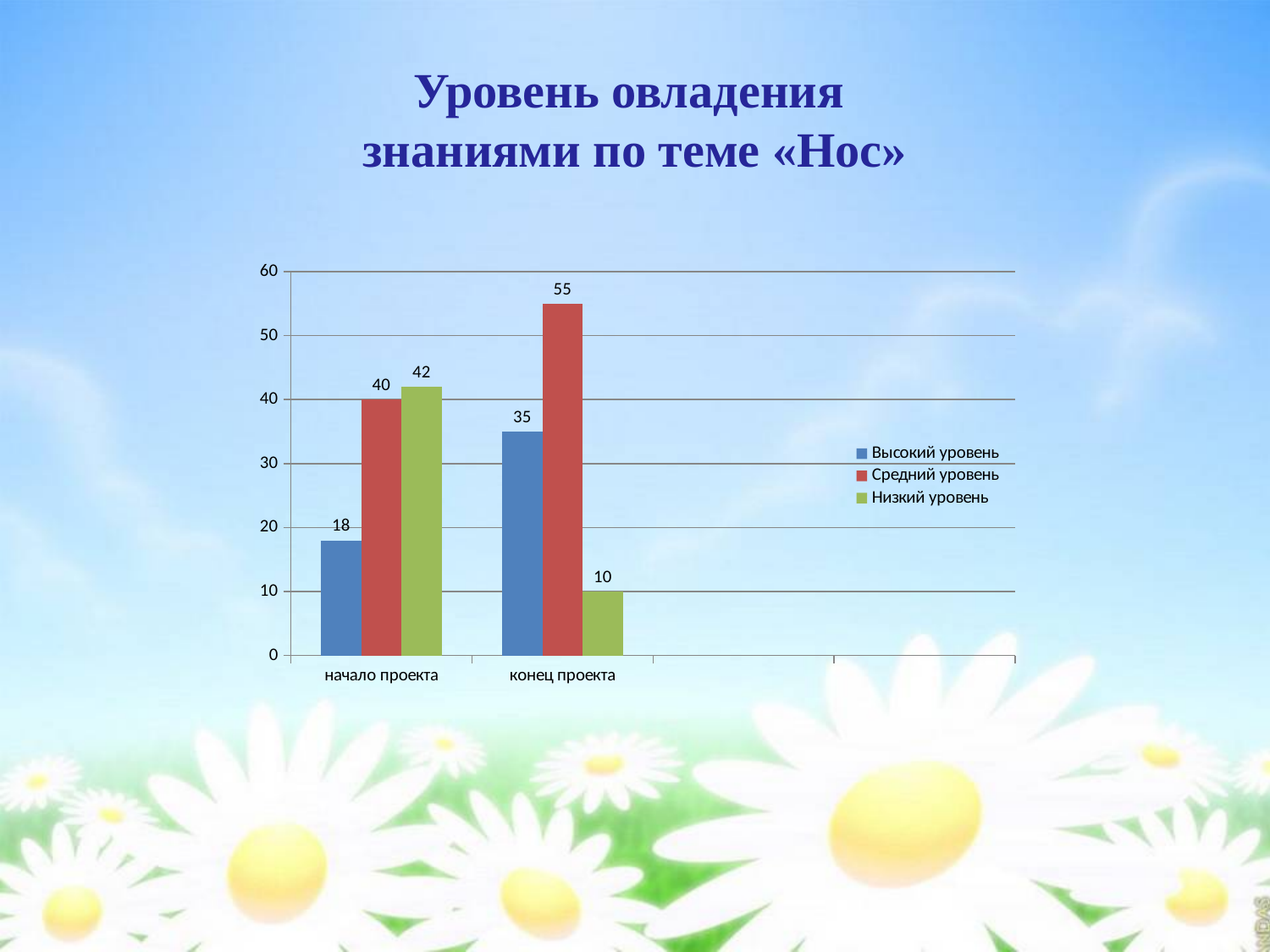
How many series does the legend list? 3 What is the value for Средний уровень at конец проекта? 55 What is the value for Высокий уровень at начало проекта? 18 What is the difference between the Высокий уровень values at конец проекта and начало проекта? 17 Does the value for Низкий уровень rise or fall from начало проекта to конец проекта? fall What kind of chart is shown on the slide? bar chart What is the value for Низкий уровень at начало проекта? 42 Which is larger: Низкий уровень at начало проекта or Низкий уровень at конец проекта? начало проекта Which series has the highest value at конец проекта? Средний уровень How many categories are shown on the x axis? 2 Which series has the lowest value at начало проекта? Высокий уровень What is the value for Низкий уровень at конец проекта? 10